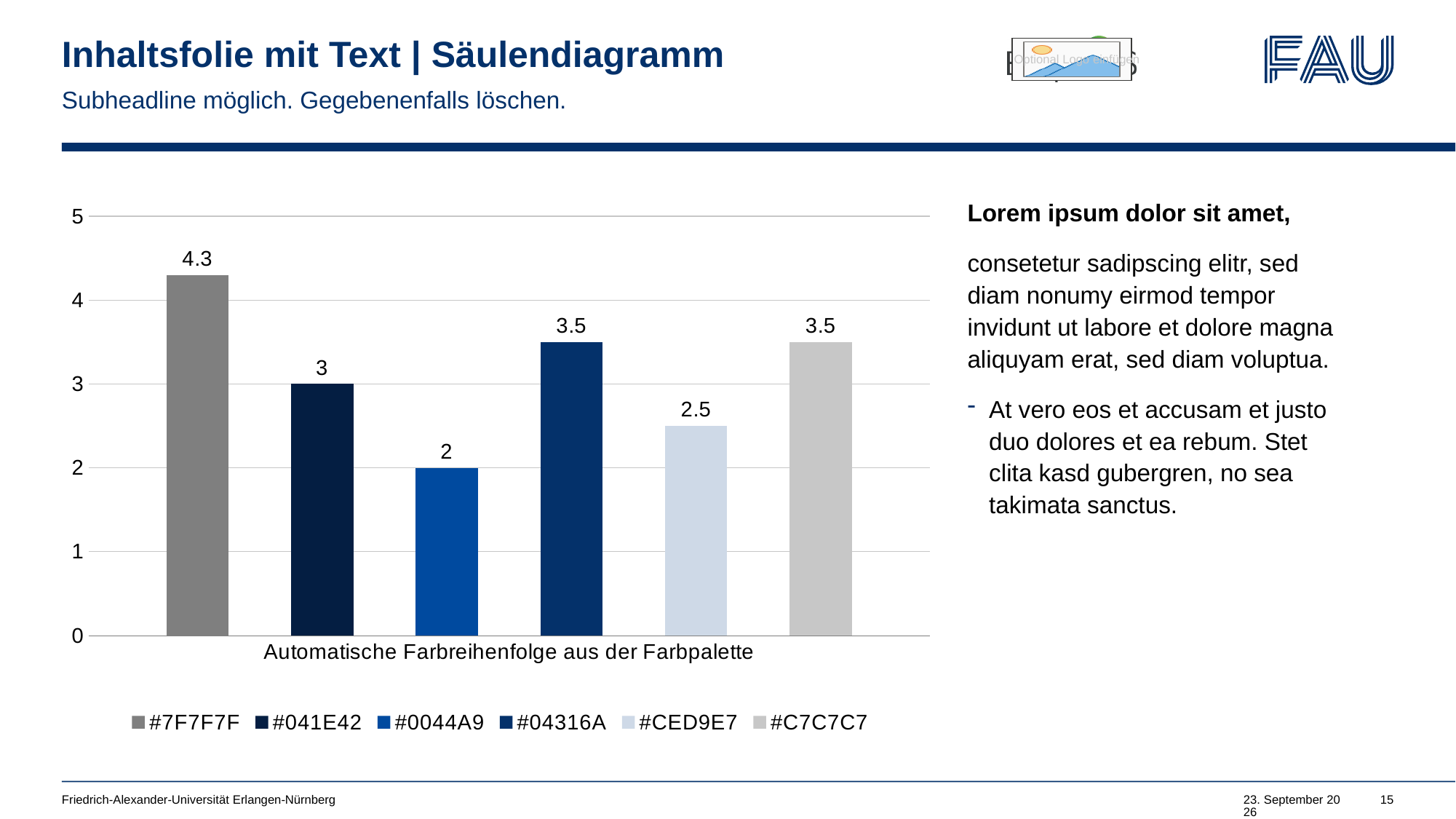
Which series has the highest value? #7F7F7F Which is larger, the value for #041E42 or the value for #CED9E7? #041E42 What is the value for the #CED9E7 series? 2.5 What is the category label shown below the bars on the x axis? Automatische Farbreihenfolge aus der Farbpalette Is the value for #04316A greater or less than 3? greater What kind of chart is shown on the slide? bar chart What is the value for the #7F7F7F series? 4.3 Which series has the lowest value? #0044A9 How many series does the legend list? 6 How many bars are plotted in the chart? 6 What is the difference between the values for #7F7F7F and #041E42? 1.3 What is the value for the #0044A9 series? 2